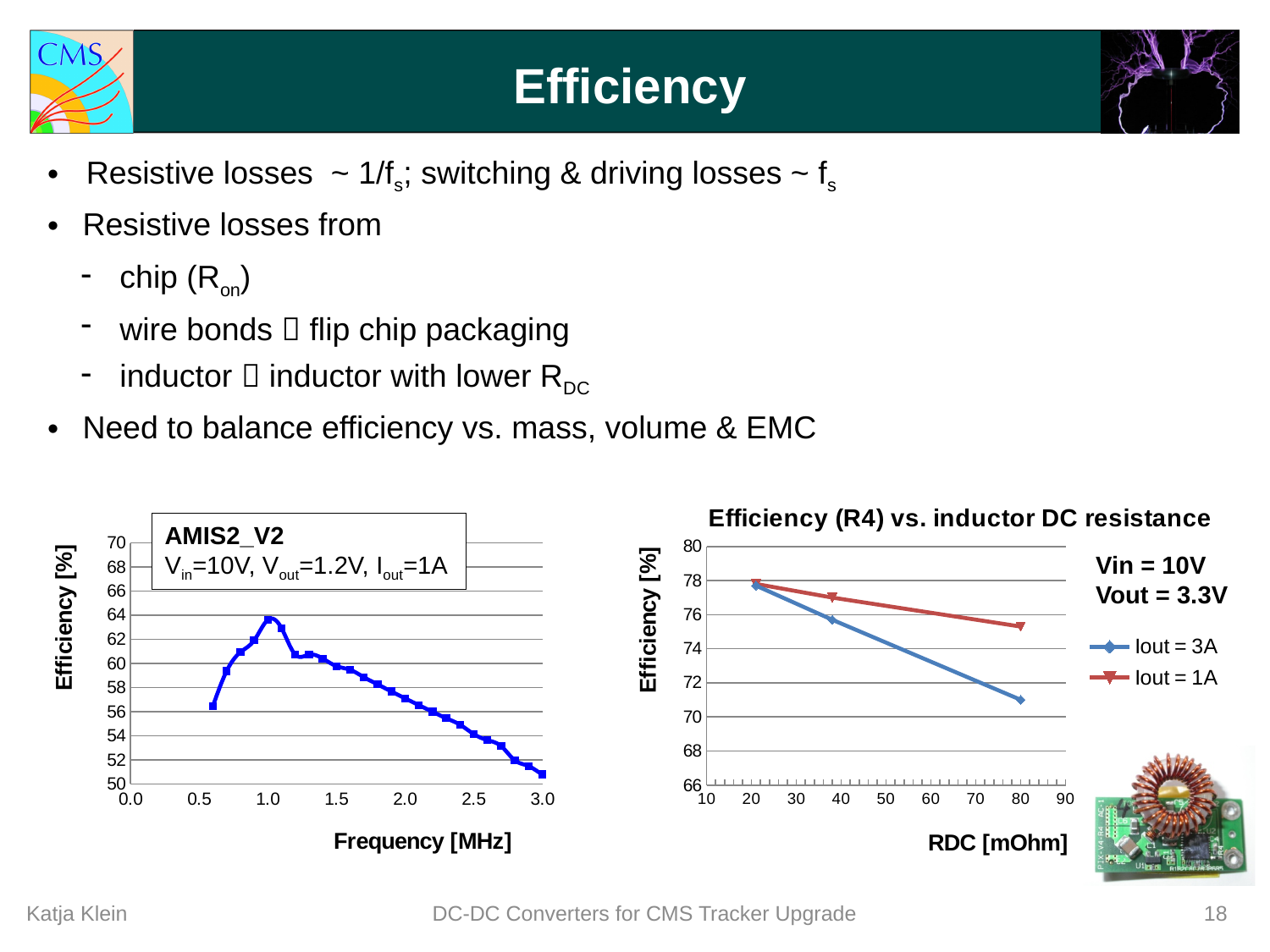
How many series does the legend of the chart 'Efficiency (R4) vs. inductor DC resistance' list? 2 What kind of chart is the left chart labelled AMIS2_V2? line chart In the left chart (AMIS2_V2), is the efficiency at 1.0 MHz greater or less than 62? greater In the left chart (AMIS2_V2), do the efficiency values rise or fall as frequency increases from 1.5 MHz to 3.0 MHz? fall In the chart 'Efficiency (R4) vs. inductor DC resistance', do the efficiency values rise or fall as RDC increases? fall In the left chart (AMIS2_V2), is the efficiency at 3.0 MHz greater or less than 52? less In the chart 'Efficiency (R4) vs. inductor DC resistance', is the Iout = 3A efficiency at 80 mOhm greater or less than 72? less What is the x-axis label of the left chart (AMIS2_V2)? Frequency [MHz] In the chart 'Efficiency (R4) vs. inductor DC resistance', which series has the higher efficiency at 80 mOhm, Iout = 3A or Iout = 1A? Iout = 1A What is the x-axis label of the chart 'Efficiency (R4) vs. inductor DC resistance'? RDC [mOhm]